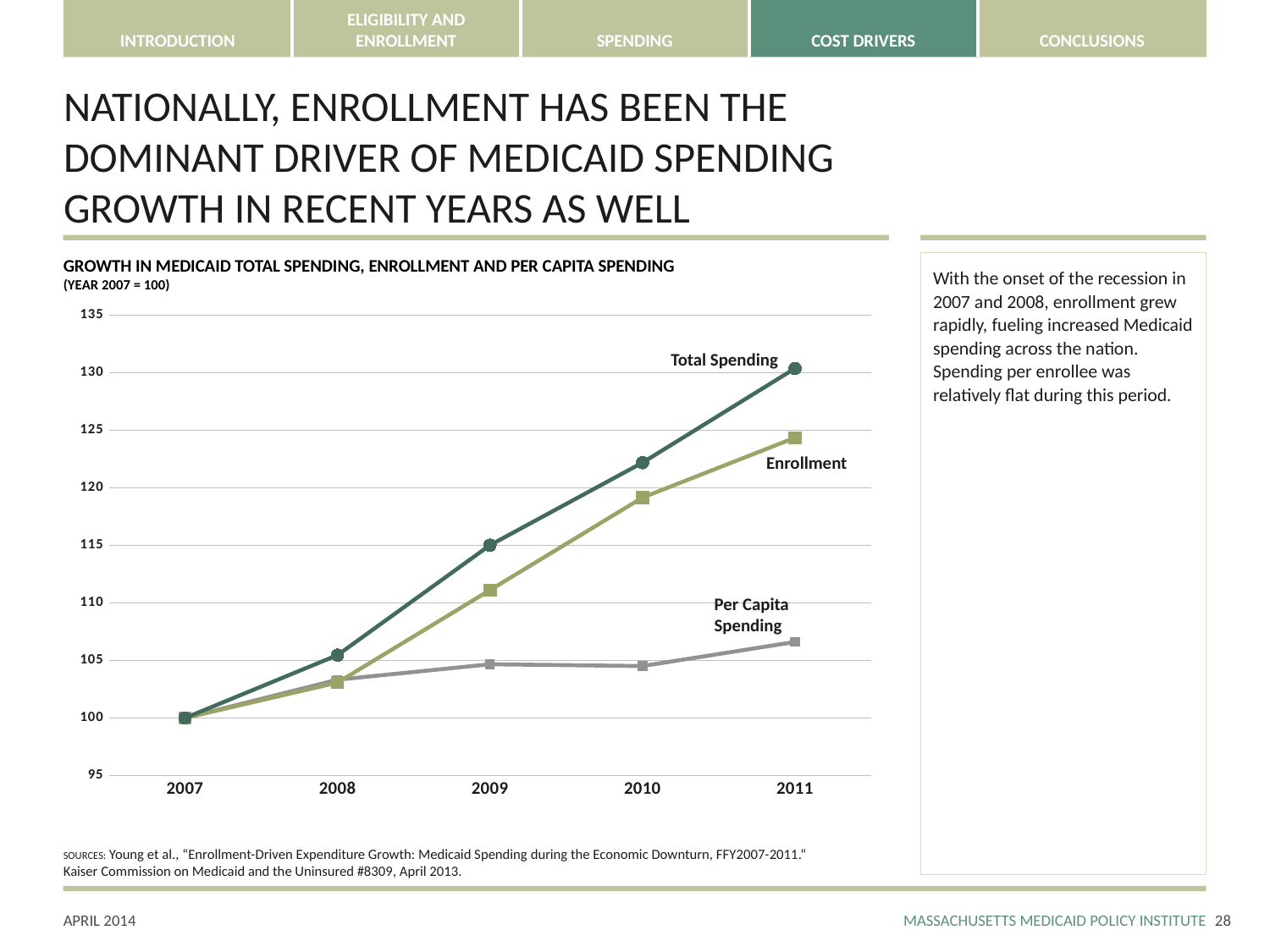
What kind of chart is shown on the slide? line chart Does Total Spending rise or fall from 2007 to 2011? rise How many years are shown on the x axis of the chart? 5 Is the value for Total Spending in 2011 greater or less than 125? greater What is the value of Total Spending in 2007? 100 Which series has the lowest value in 2011? Per Capita Spending Is the value for Enrollment in 2011 greater or less than 120? greater What base year is the index set to 100 in the chart? 2007 In 2010, which is larger: Enrollment or Per Capita Spending? Enrollment Which series has the highest value in 2011? Total Spending Is the value for Per Capita Spending in 2011 greater or less than 110? less How many series are plotted on the chart? 3